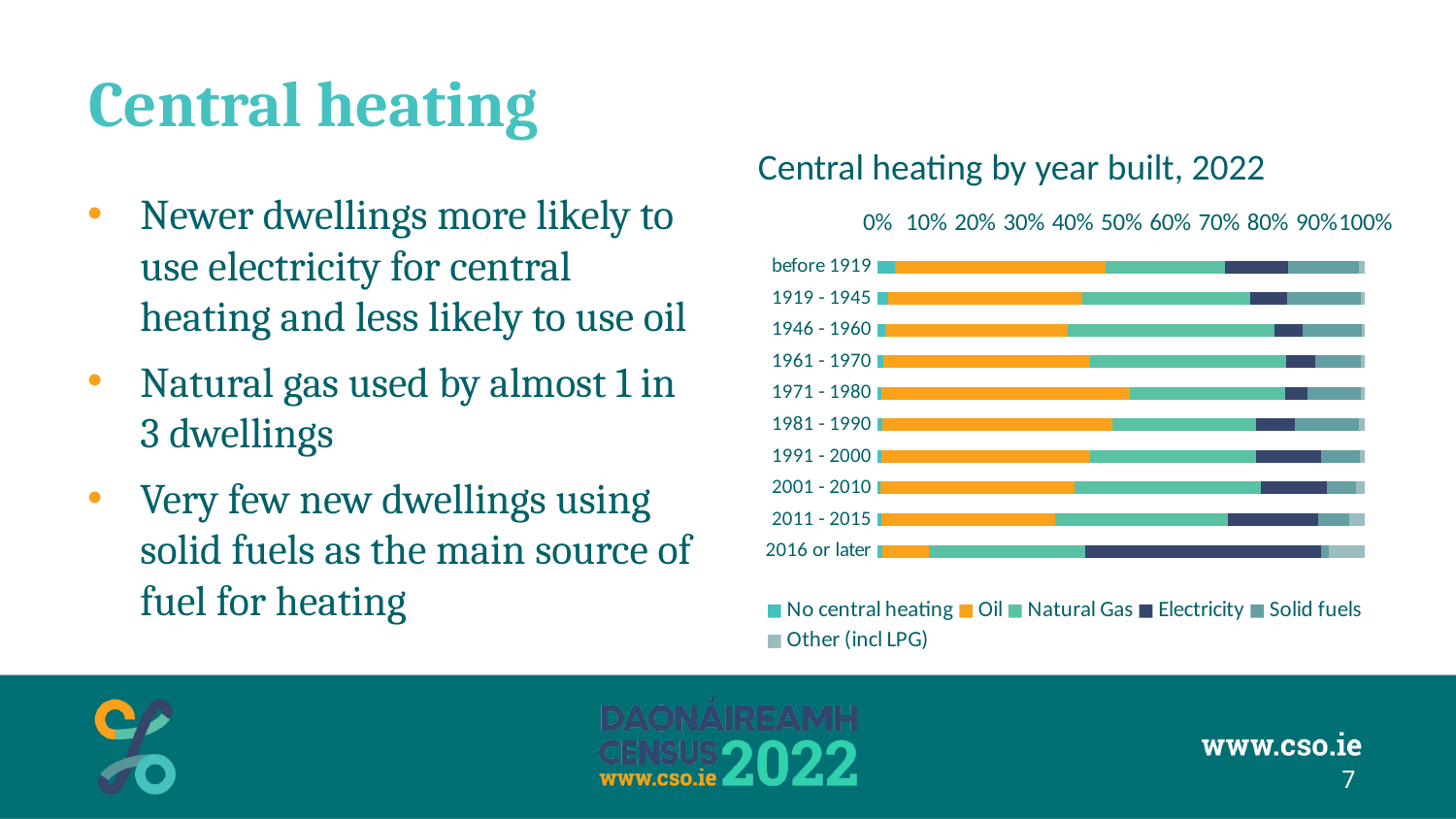
What is the title of the chart? Central heating by year built, 2022 Is the Oil share for dwellings built before 1919 greater or less than 40%? greater Which has the larger Electricity share: dwellings built 1919 - 1945 or dwellings built 2011 - 2015? 2011 - 2015 Is the Oil share for dwellings built 2016 or later greater or less than 20%? less How many series does the chart legend list? 6 Which has the larger Oil share: dwellings built before 1919 or dwellings built 2016 or later? before 1919 Which fuel series is shown in orange in the chart? Oil Which year-built category has the smallest Oil share? 2016 or later What kind of chart is shown on the slide? Stacked bar chart Which year-built category has the largest Electricity share? 2016 or later Is the Electricity share for dwellings built 2016 or later greater or less than 40%? greater How many year-built categories are shown in the chart? 10